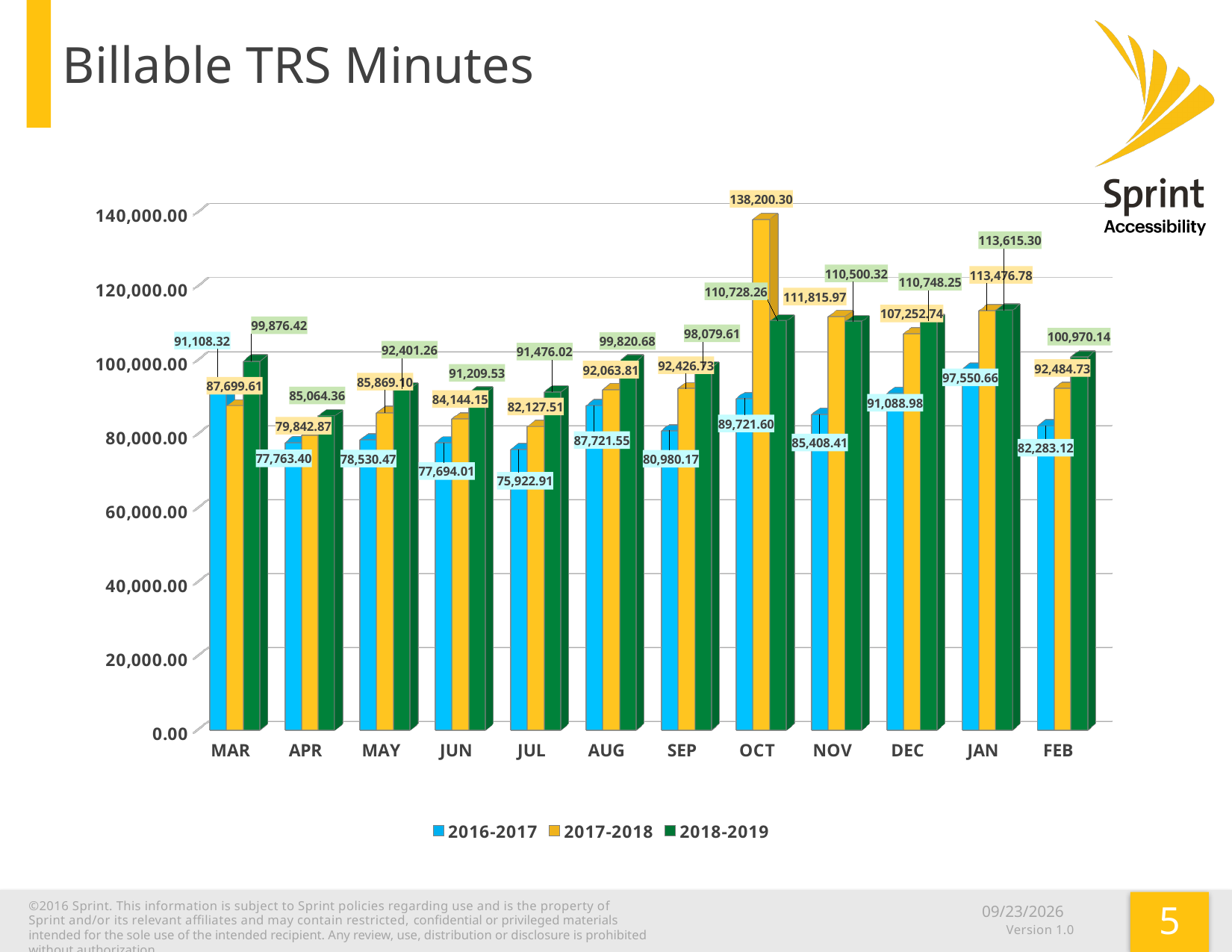
Is the value for 2016-2017 in OCT greater or less than 100,000.00? less In NOV, which is larger: the 2017-2018 value or the 2018-2019 value? 2017-2018 Which month has the highest value for the 2016-2017 series? JAN What is the value for 2017-2018 in OCT? 138,200.30 What is the difference between the 2017-2018 and 2018-2019 values in OCT? 27,472.04 Which month has the lowest value for the 2016-2017 series? JUL What is the value for 2018-2019 in JAN? 113,615.30 Which series and month has the tallest bar on the chart? 2017-2018, OCT How many series does the legend list? 3 What is the value for 2016-2017 in JUL? 75,922.91 How many months are shown on the x axis? 12 What kind of chart is shown on the slide? bar chart